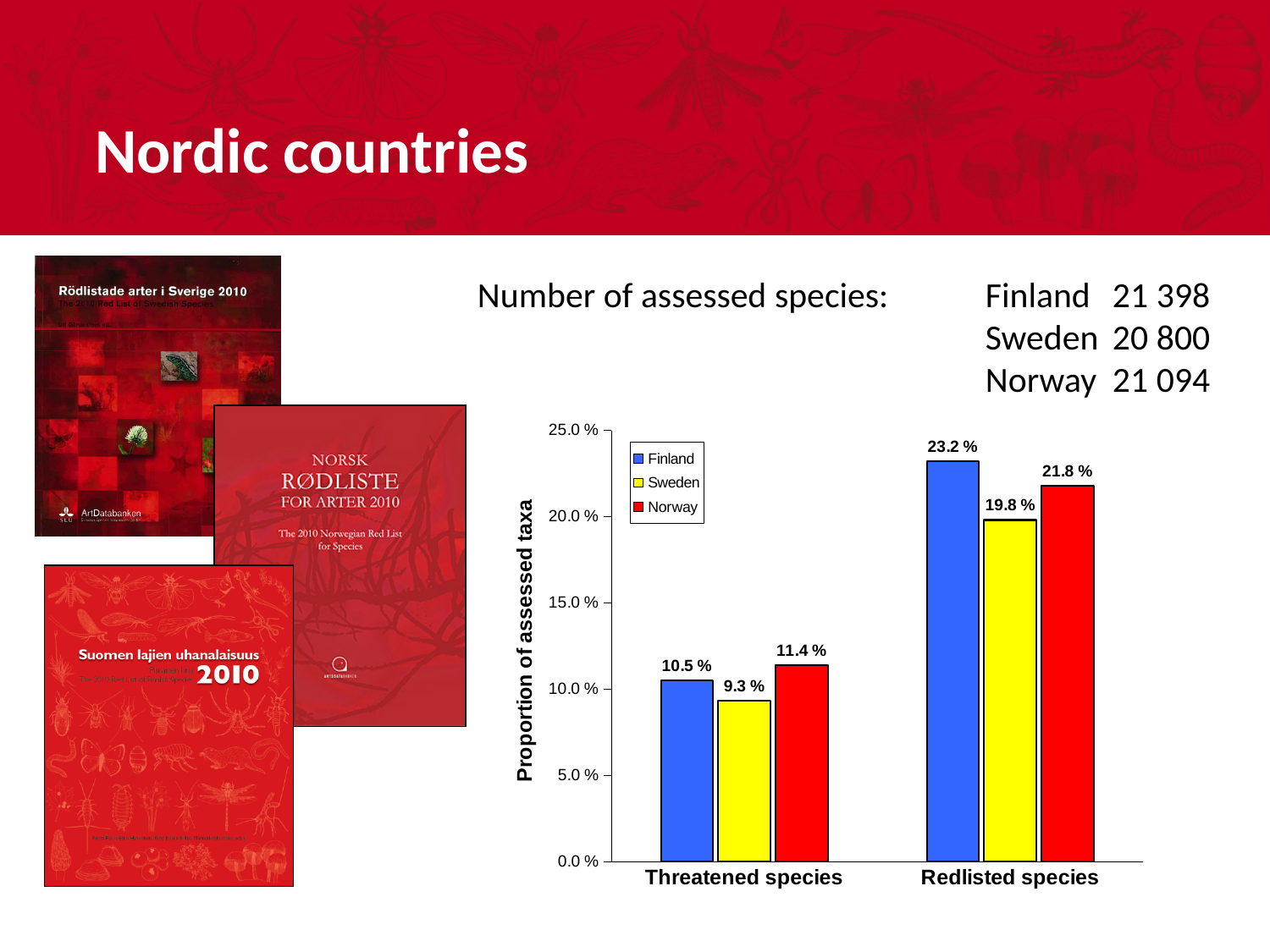
What is the proportion of redlisted species for Norway? 21.8 % What is the proportion of redlisted species for Sweden? 19.8 % What kind of chart is shown on the slide? Bar chart Which country has the highest proportion of redlisted species? Finland How many categories are shown on the x axis? 2 What is the label of the y axis? Proportion of assessed taxa What is the difference between Finland's and Sweden's proportion of redlisted species? 3.4 % How many series does the legend list? 3 Which is larger: Norway's proportion of threatened species or Finland's proportion of threatened species? Norway's What is the difference between Norway's and Sweden's proportion of threatened species? 2.1 % Which country has the lowest proportion of threatened species? Sweden What is the proportion of threatened species for Finland? 10.5 %